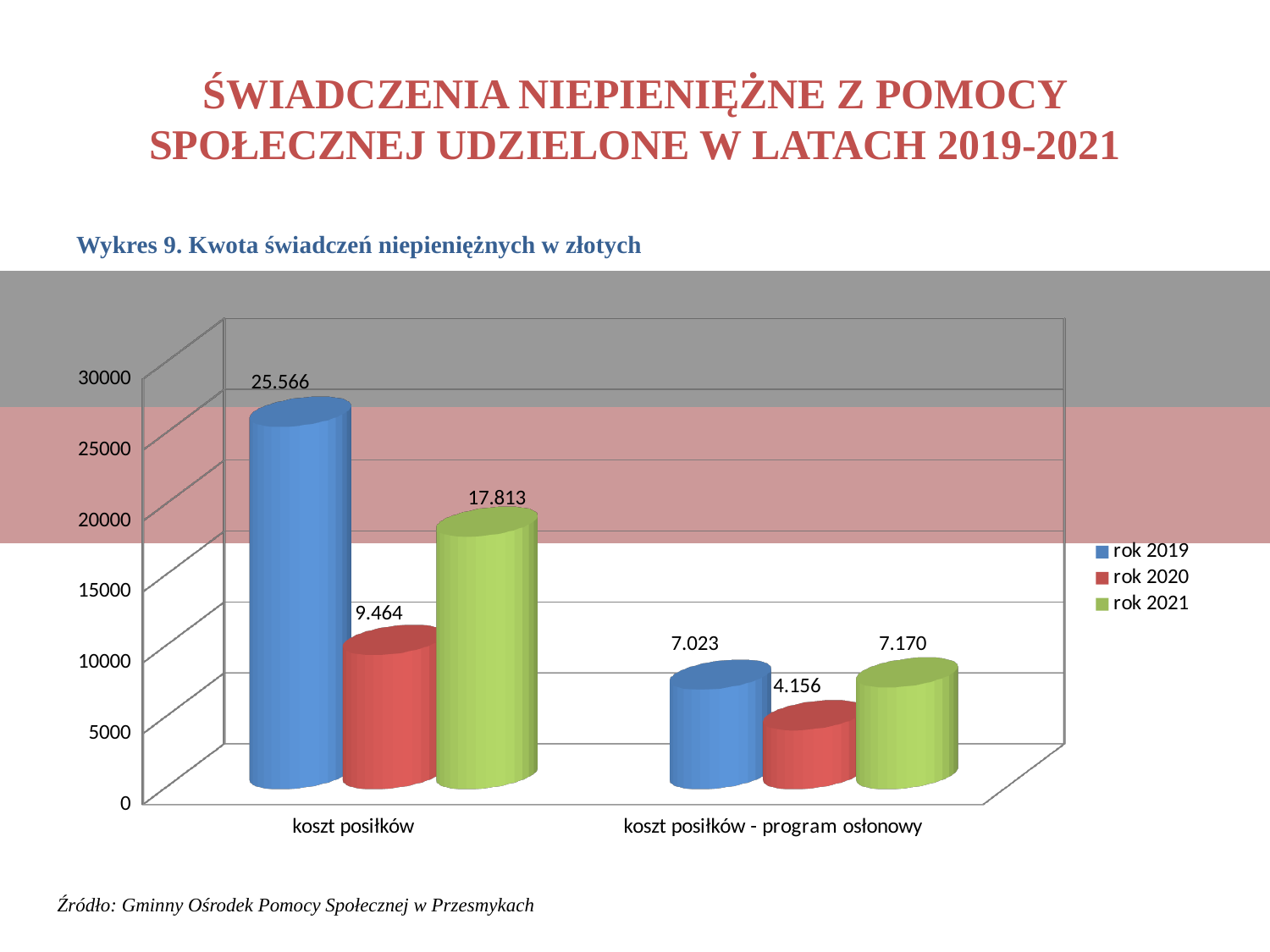
Which series has the lowest value in the koszt posiłków - program osłonowy category? rok 2020 What is the value for rok 2020 in the koszt posiłków - program osłonowy category? 4.156 Which is larger in the koszt posiłków - program osłonowy category: rok 2019 or rok 2021? rok 2021 Is the value for rok 2021 in the koszt posiłków category greater or less than 15000? greater How many categories are shown on the x axis? 2 Which series has the highest value in the koszt posiłków category? rok 2019 What is the difference between the rok 2019 and rok 2020 values in the koszt posiłków category? 16.102 What is the value for rok 2021 in the koszt posiłków category? 17.813 What is the value for rok 2019 in the koszt posiłków category? 25.566 How many series does the legend list? 3 What kind of chart is shown on the slide? bar chart What is the difference between the rok 2021 and rok 2019 values in the koszt posiłków - program osłonowy category? 147